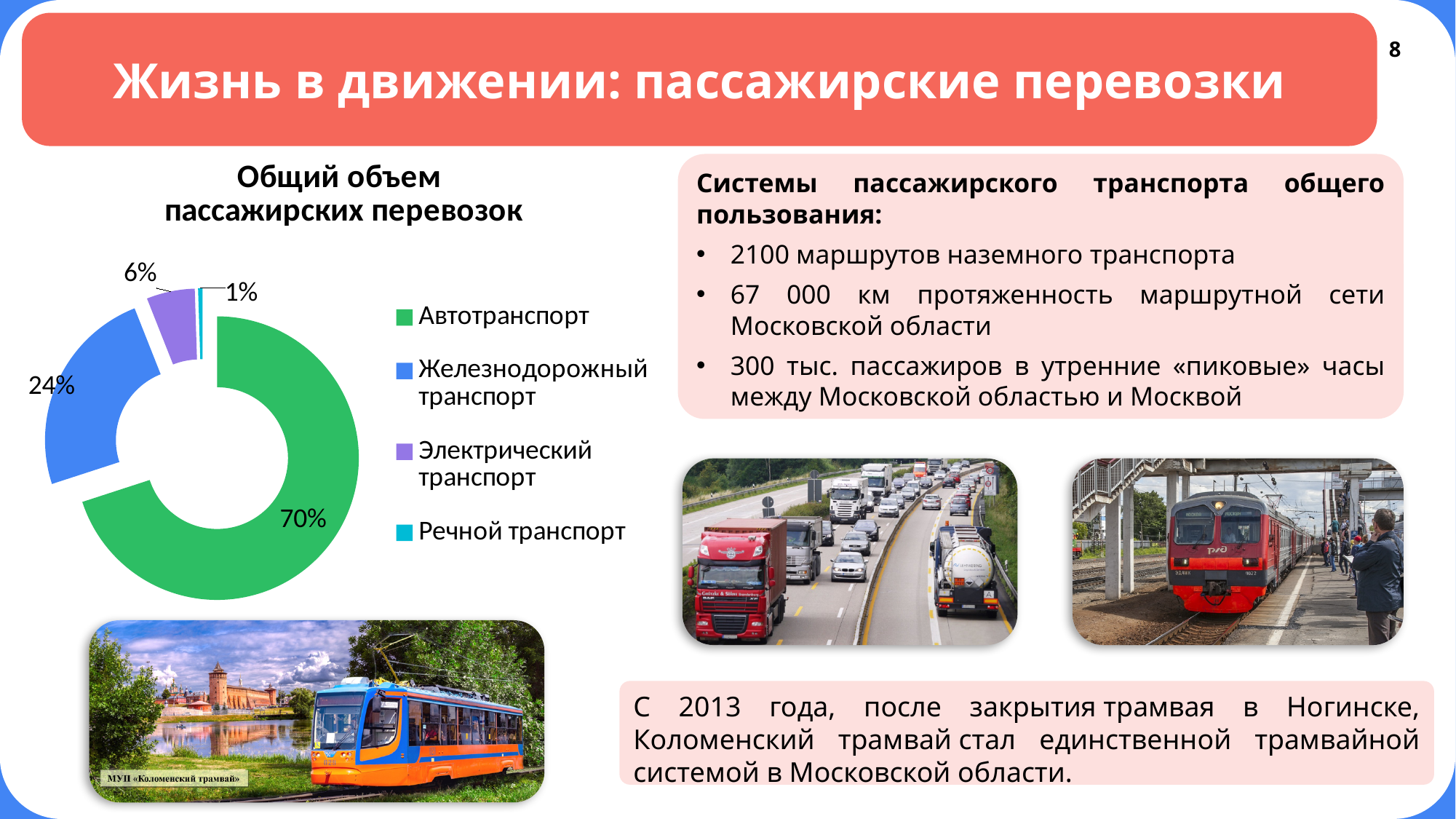
Which transport type has the smallest share in the chart? Речной транспорт How many categories does the chart show? 4 What share of total passenger transport does Автотранспорт account for? 70% What colour represents Электрический транспорт in the chart? Purple What is the title of the chart? Общий объем пассажирских перевозок What kind of chart is shown on the slide? Pie chart (doughnut) What share of total passenger transport does Речной транспорт account for? 1% Which transport type has the largest share in the chart? Автотранспорт What share of total passenger transport does Электрический транспорт account for? 6% What share of total passenger transport does Железнодорожный транспорт account for? 24% Which has a larger share, Железнодорожный транспорт or Электрический транспорт? Железнодорожный транспорт What is the difference in percentage points between Автотранспорт and Железнодорожный транспорт? 46